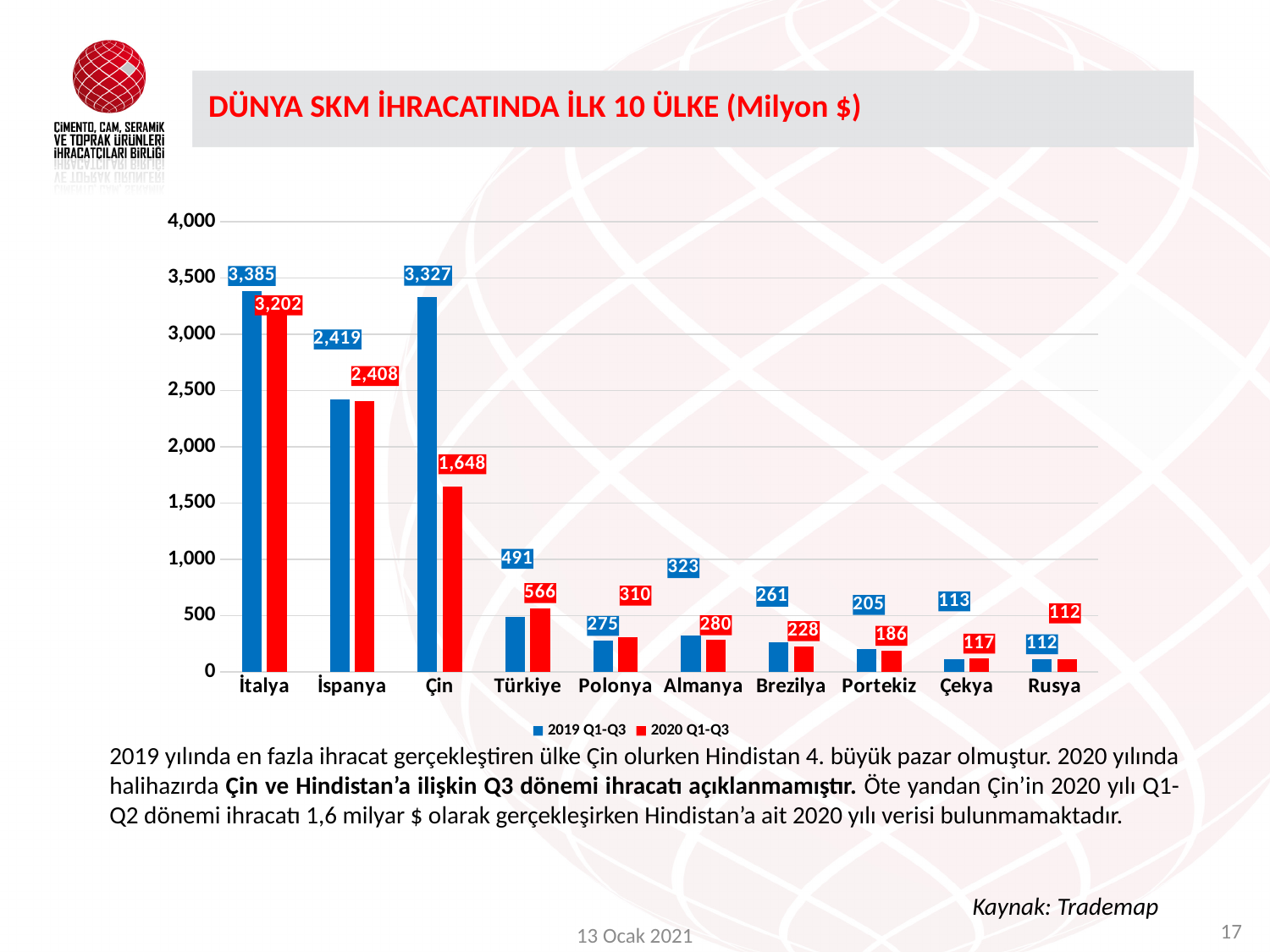
Which is larger for Türkiye: the 2019 Q1-Q3 value or the 2020 Q1-Q3 value? 2020 Q1-Q3 How many series does the legend list? 2 What is the 2019 Q1-Q3 value for İtalya? 3,385 How many countries are shown on the x axis? 10 What is the 2020 Q1-Q3 value for Çin? 1,648 What is the title of the chart? DÜNYA SKM İHRACATINDA İLK 10 ÜLKE (Milyon $) What is the 2020 Q1-Q3 value for Türkiye? 566 What is the 2020 Q1-Q3 value for Portekiz? 186 Which country has the highest 2019 Q1-Q3 value? İtalya Which country has the lowest 2020 Q1-Q3 value? Rusya What kind of chart is shown on the slide? Bar chart What is the difference between the 2019 Q1-Q3 and 2020 Q1-Q3 values for Çin? 1,679